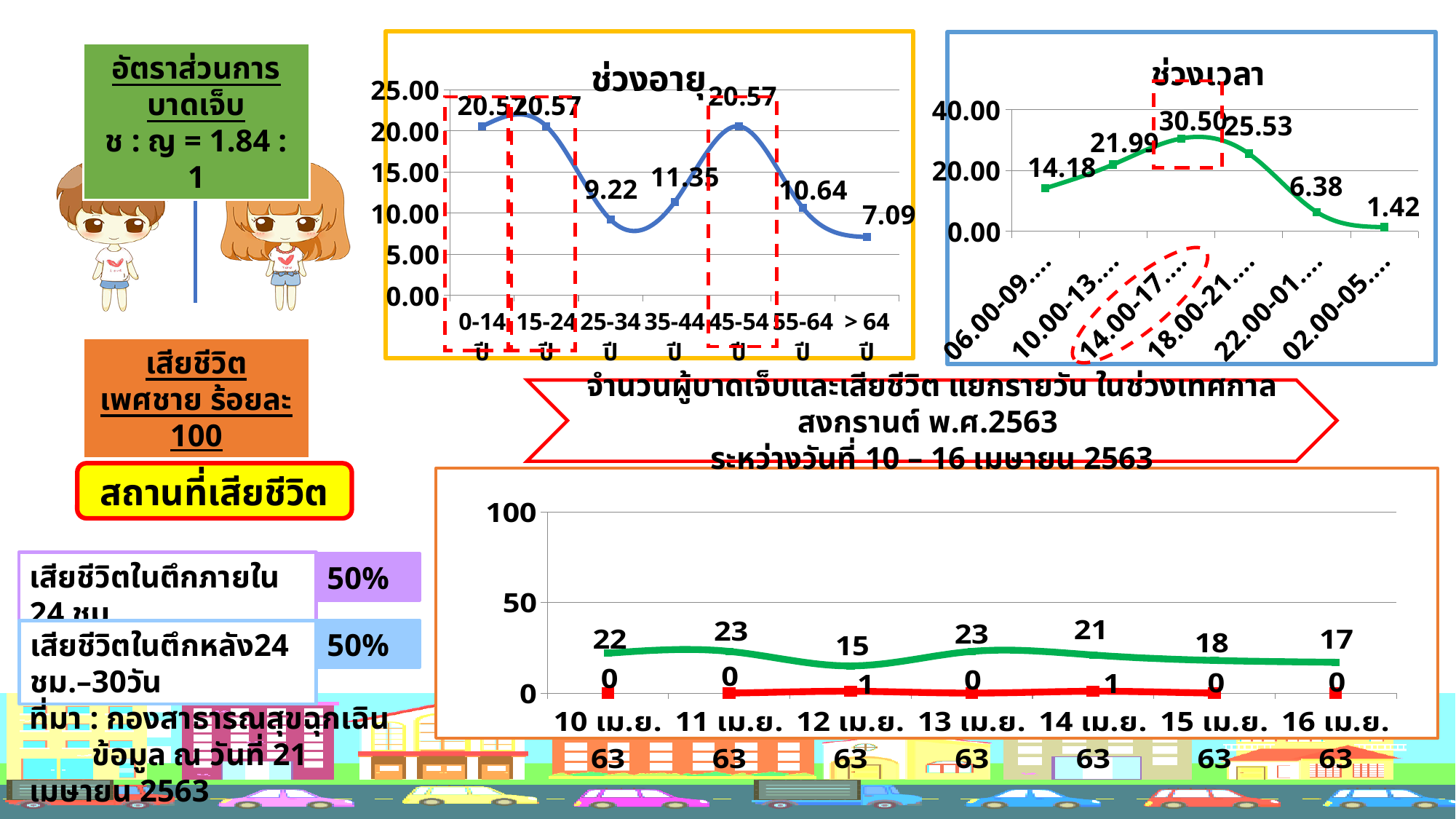
In the ช่วงเวลา chart, is the value for 06.00-09... greater or less than 20.00? less In the bottom chart of daily injuries and deaths, what kind of chart is it? line chart In the ช่วงเวลา chart, which time period has the lowest value? 02.00-05... In the ช่วงอายุ chart, what is the difference between the values for 35-44 ปี and 25-34 ปี? 2.13 In the ช่วงอายุ chart, what is the value for the > 64 ปี age group? 7.09 In the ช่วงอายุ chart, which age group has the lowest value? > 64 ปี In the bottom chart of daily injuries and deaths, what is the value of the green line on 12 เม.ย. 63? 15 In the ช่วงอายุ chart, what is the value for the 25-34 ปี age group? 9.22 In the ช่วงอายุ chart, how many age groups are plotted? 7 In the ช่วงเวลา chart, which time period has the highest value? 14.00-17... In the ช่วงเวลา chart, what is the difference between the values for 18.00-21... and 22.00-01...? 19.15 In the ช่วงเวลา chart, what is the value for the 14.00-17... time period? 30.50